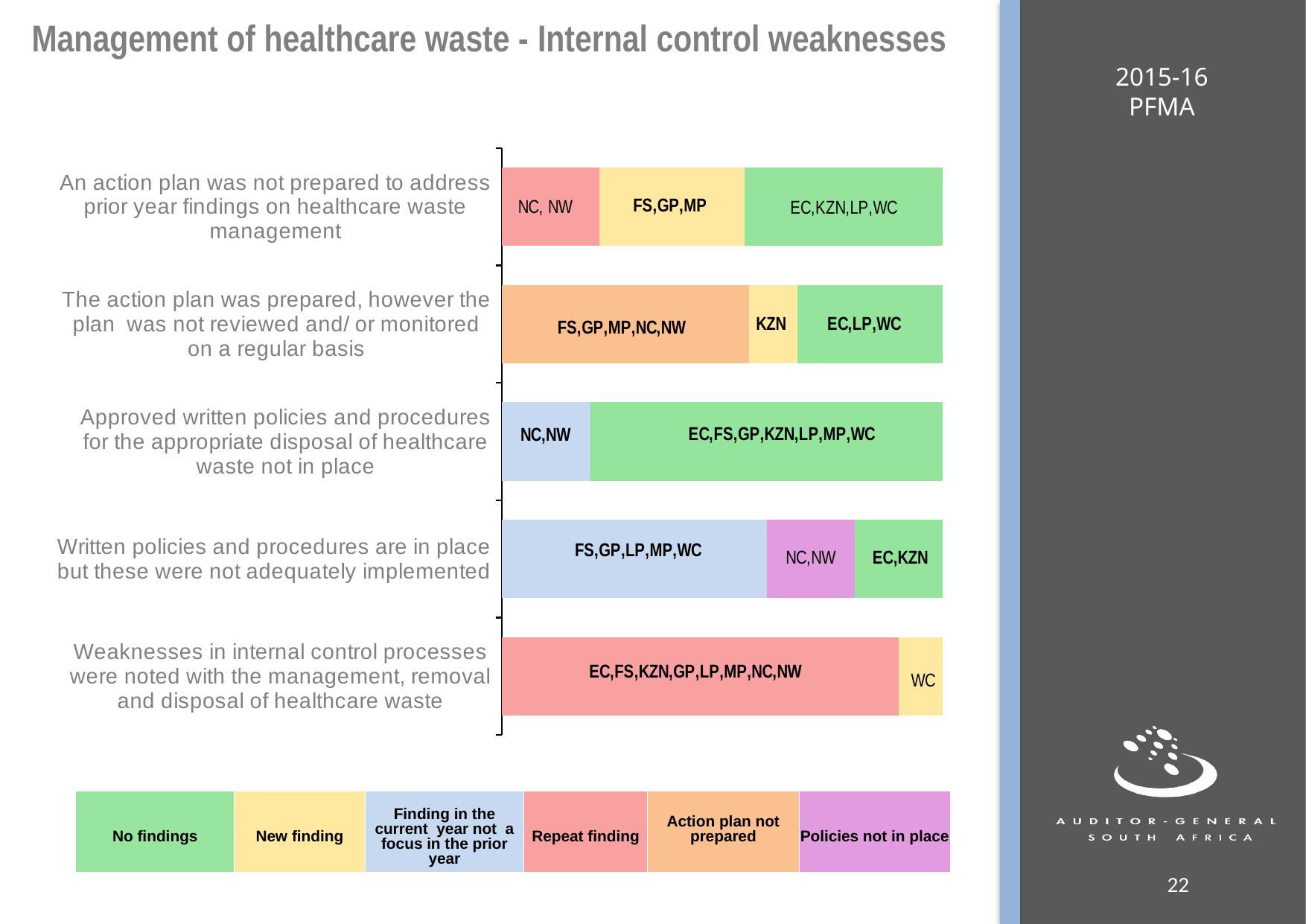
How many internal control weakness categories (bars) does the chart show? 5 Which province is labelled in the 'New finding' segment of the bar 'Weaknesses in internal control processes were noted with the management, removal and disposal of healthcare waste'? WC What kind of chart is shown on the slide? Stacked horizontal bar chart Which provinces are labelled in the 'Action plan not prepared' segment of the bar 'The action plan was prepared, however the plan was not reviewed and/ or monitored on a regular basis'? FS,GP,MP,NC,NW How many entries does the legend list? 6 Which provinces are labelled in the 'No findings' segment of the bar 'Approved written policies and procedures for the appropriate disposal of healthcare waste not in place'? EC,FS,GP,KZN,LP,MP,WC Which provinces are labelled in the 'Policies not in place' segment of the bar 'Written policies and procedures are in place but these were not adequately implemented'? NC,NW Which provinces are labelled in the 'Repeat finding' segment of the bar 'Weaknesses in internal control processes were noted with the management, removal and disposal of healthcare waste'? EC,FS,KZN,GP,LP,MP,NC,NW Which provinces are labelled in the 'No findings' segment of the bar 'An action plan was not prepared to address prior year findings on healthcare waste management'? EC,KZN,LP,WC In the bar 'Weaknesses in internal control processes were noted with the management, removal and disposal of healthcare waste', which segment is larger: 'Repeat finding' or 'New finding'? Repeat finding Which province is labelled in the 'New finding' segment of the bar 'The action plan was prepared, however the plan was not reviewed and/ or monitored on a regular basis'? KZN Which legend entry is shown in light blue? Finding in the current year not a focus in the prior year